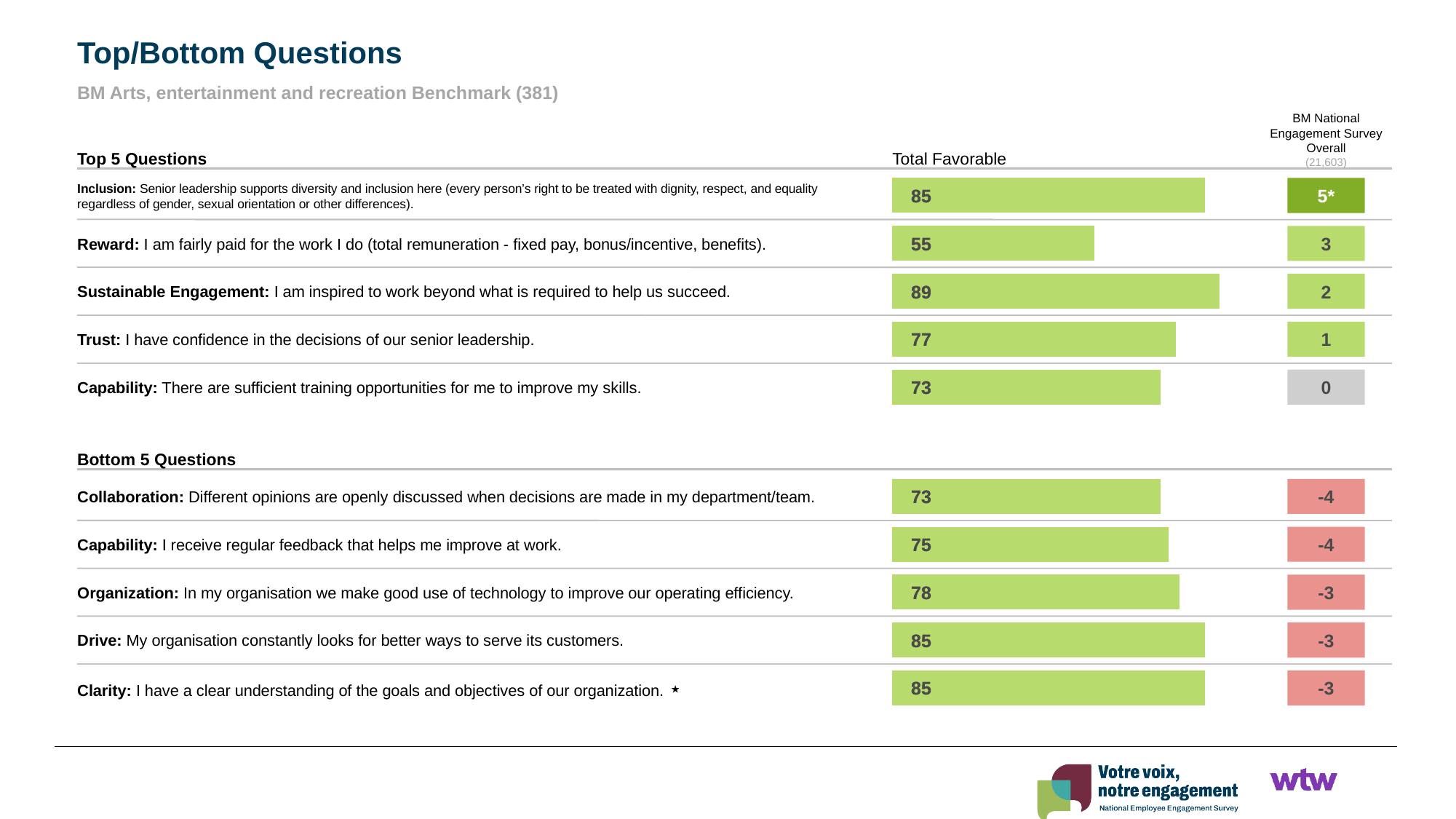
In the Bottom 5 Questions chart, is the Total Favorable value for the Drive question larger or smaller than that for the Capability question? larger In the Bottom 5 Questions chart, which question has the lowest Total Favorable value? Collaboration In the Top 5 Questions chart, what is the Total Favorable value for the Reward question? 55 In the Top 5 Questions chart, what is the Total Favorable value for the Sustainable Engagement question? 89 In the Bottom 5 Questions chart, what is the BM National Engagement Survey Overall difference shown for the Capability question? -4 In the Top 5 Questions chart, which question has the highest Total Favorable value? Sustainable Engagement In the Bottom 5 Questions chart, what is the Total Favorable value for the Organization question? 78 In the Top 5 Questions chart, what is the difference in Total Favorable between the Inclusion question and the Trust question? 8 What kind of chart is used to show the Total Favorable values on this slide? bar chart How many questions are listed in the Bottom 5 Questions chart? 5 In the Top 5 Questions chart, what is the BM National Engagement Survey Overall difference shown for the Inclusion question? 5* In the Top 5 Questions chart, which question has the lowest Total Favorable value? Reward